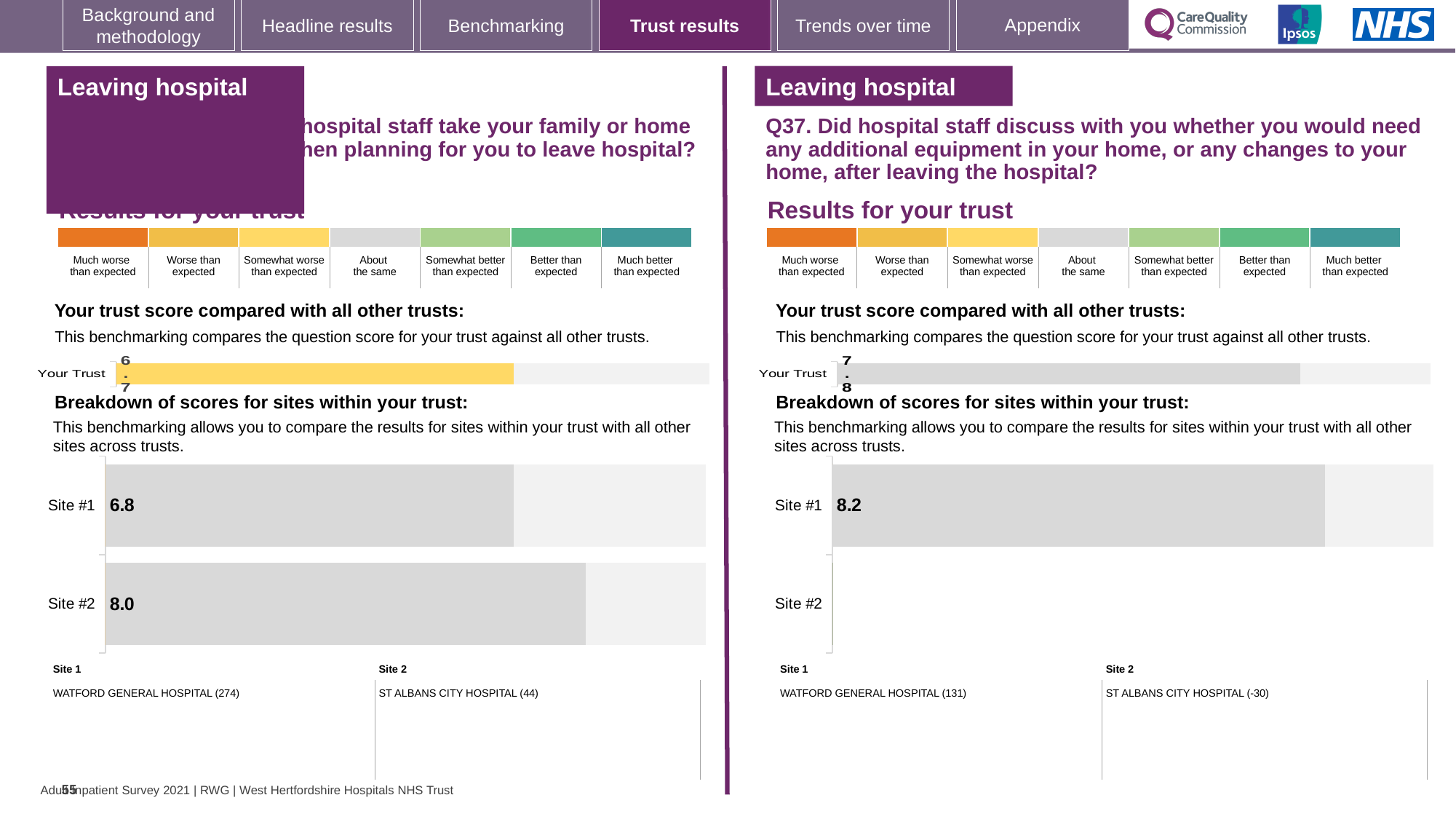
In the right-hand site breakdown chart (Q37), what is the score for Site #1? 8.2 How many sites are listed in the left-hand site breakdown chart? 2 On the right half of the slide (Q37), what is the 'Your Trust' score shown in the trust score bar chart? 7.8 In the left-hand site breakdown chart, what is the difference between the Site #2 and Site #1 scores? 1.2 In the left-hand site breakdown chart, what is the score for Site #1? 6.8 What type of chart is used to show the site breakdown of scores on the slide? Bar chart What is the difference between the 'Your Trust' scores on the right half (Q37) and the left half of the slide? 1.1 On the left half of the slide, what is the 'Your Trust' score shown in the trust score bar chart? 6.7 In the left-hand site breakdown chart, which site has the higher score? Site #2 Is the 'Your Trust' score on the right half of the slide (Q37) larger than the 'Your Trust' score on the left half? Yes What colour is the 'Your Trust' bar in the trust score chart on the left half of the slide? Yellow In the left-hand site breakdown chart, what is the score for Site #2? 8.0